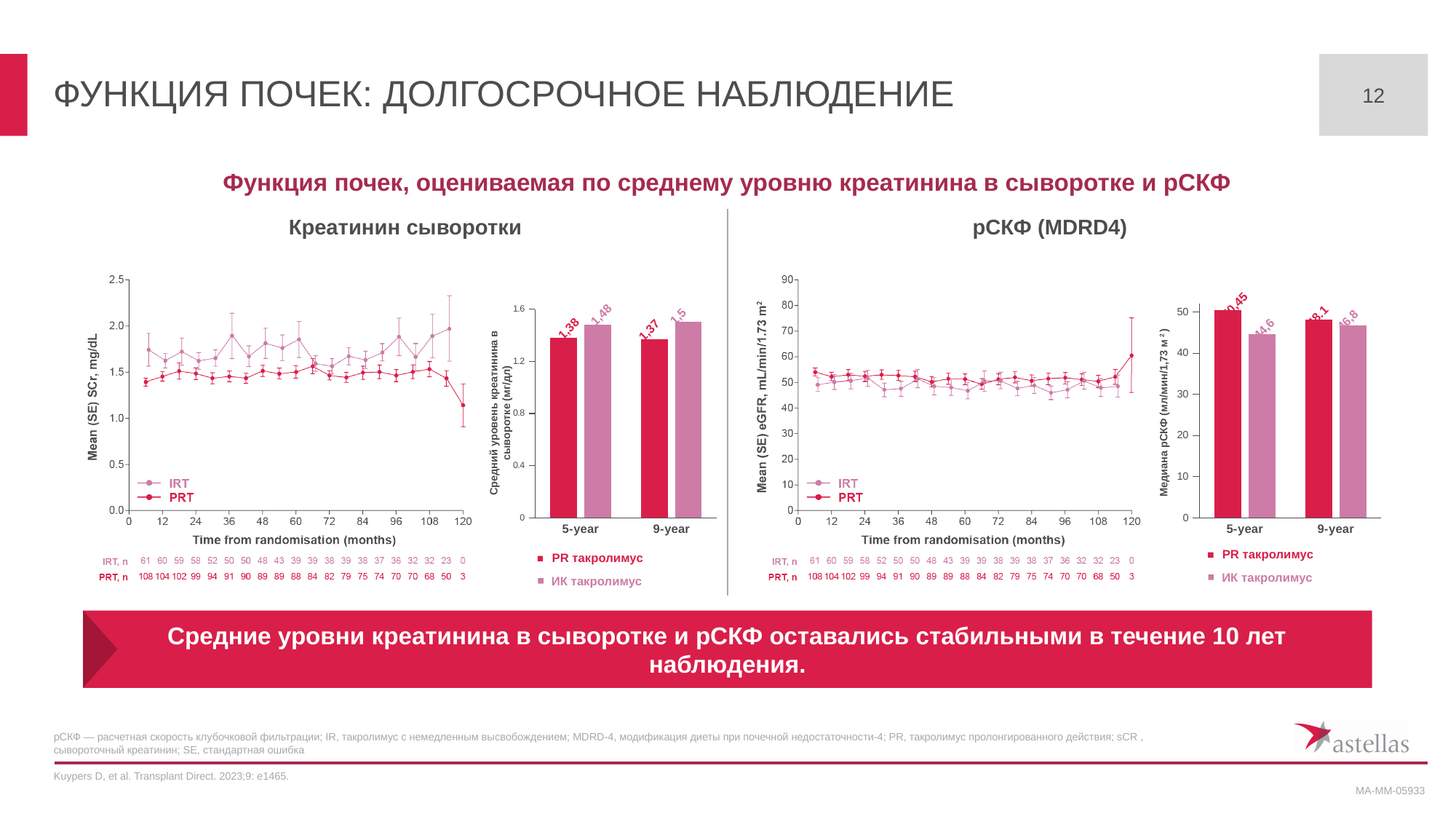
In the "Креатинин сыворотки" line chart, is the PRT value at 120 months greater or less than 1.5? less What are the two legend entries of the bar chart next to "рСКФ (MDRD4)"? PR такролимус and ИК такролимус How many series does the legend of the "Креатинин сыворотки" line chart list? 2 In the bar chart next to "Креатинин сыворотки", what is the value for PR такролимус at 5-year? 1,38 How many categories are shown on the x axis of the bar chart next to "рСКФ (MDRD4)"? 2 In the bar chart next to "Креатинин сыворотки", which is larger at 5-year: PR такролимус or ИК такролимус? ИК такролимус In the bar chart next to "рСКФ (MDRD4)", what is the difference between PR такролимус and ИК такролимус at 9-year? 1,3 What kind of chart is the "Креатинин сыворотки" chart on the left of the slide? line chart In the bar chart next to "рСКФ (MDRD4)", what is the value for ИК такролимус at 5-year? 44,6 In the bar chart next to "Креатинин сыворотки", what is the difference between ИК такролимус and PR такролимус at 9-year? 0,13 In the bar chart next to "рСКФ (MDRD4)", what is the value for PR такролимус at 9-year? 48,1 In the bar chart next to "Креатинин сыворотки", what is the value for ИК такролимус at 9-year? 1,5